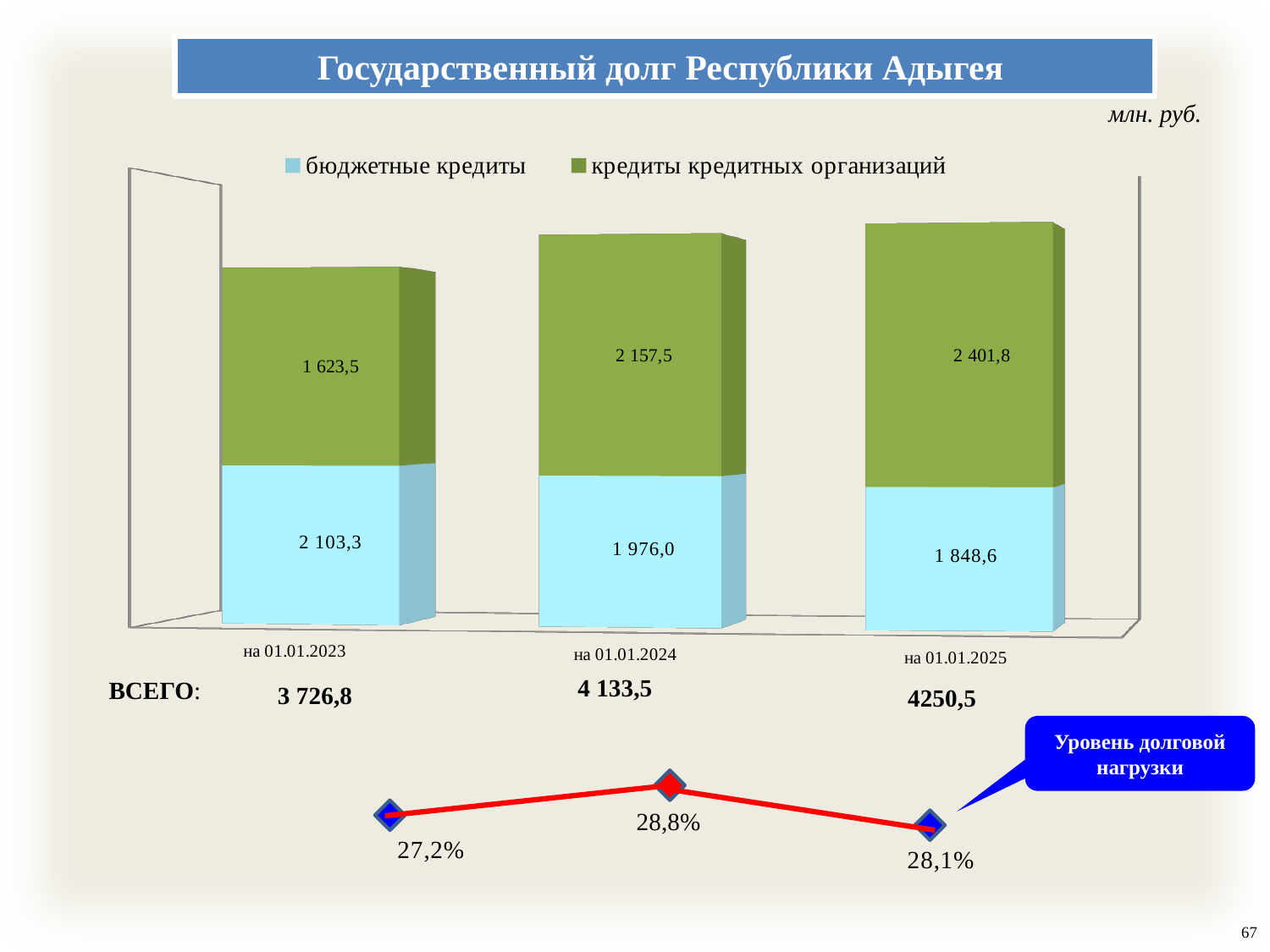
In the stacked bar chart, what is the difference between кредиты кредитных организаций на 01.01.2025 and на 01.01.2023? 778,3 In the line chart labelled Уровень долговой нагрузки, what is the value at the middle point? 28,8% In the stacked bar chart, what is the value of кредиты кредитных организаций на 01.01.2025? 2 401,8 In the stacked bar chart, on which date is the value of бюджетные кредиты lowest? на 01.01.2025 In the stacked bar chart, on which date is the value of кредиты кредитных организаций highest? на 01.01.2025 In the stacked bar chart, does the value of бюджетные кредиты rise or fall from 01.01.2023 to 01.01.2025? fall In the stacked bar chart, what is the value of кредиты кредитных организаций на 01.01.2024? 2 157,5 What is the total (ВСЕГО) of the stacked bar на 01.01.2023? 3 726,8 How many dates (categories) are shown in the stacked bar chart? 3 How many series does the legend of the stacked bar chart list? 2 In the stacked bar chart, what is the value of бюджетные кредиты на 01.01.2023? 2 103,3 In the stacked bar chart, which is larger на 01.01.2024: бюджетные кредиты or кредиты кредитных организаций? кредиты кредитных организаций